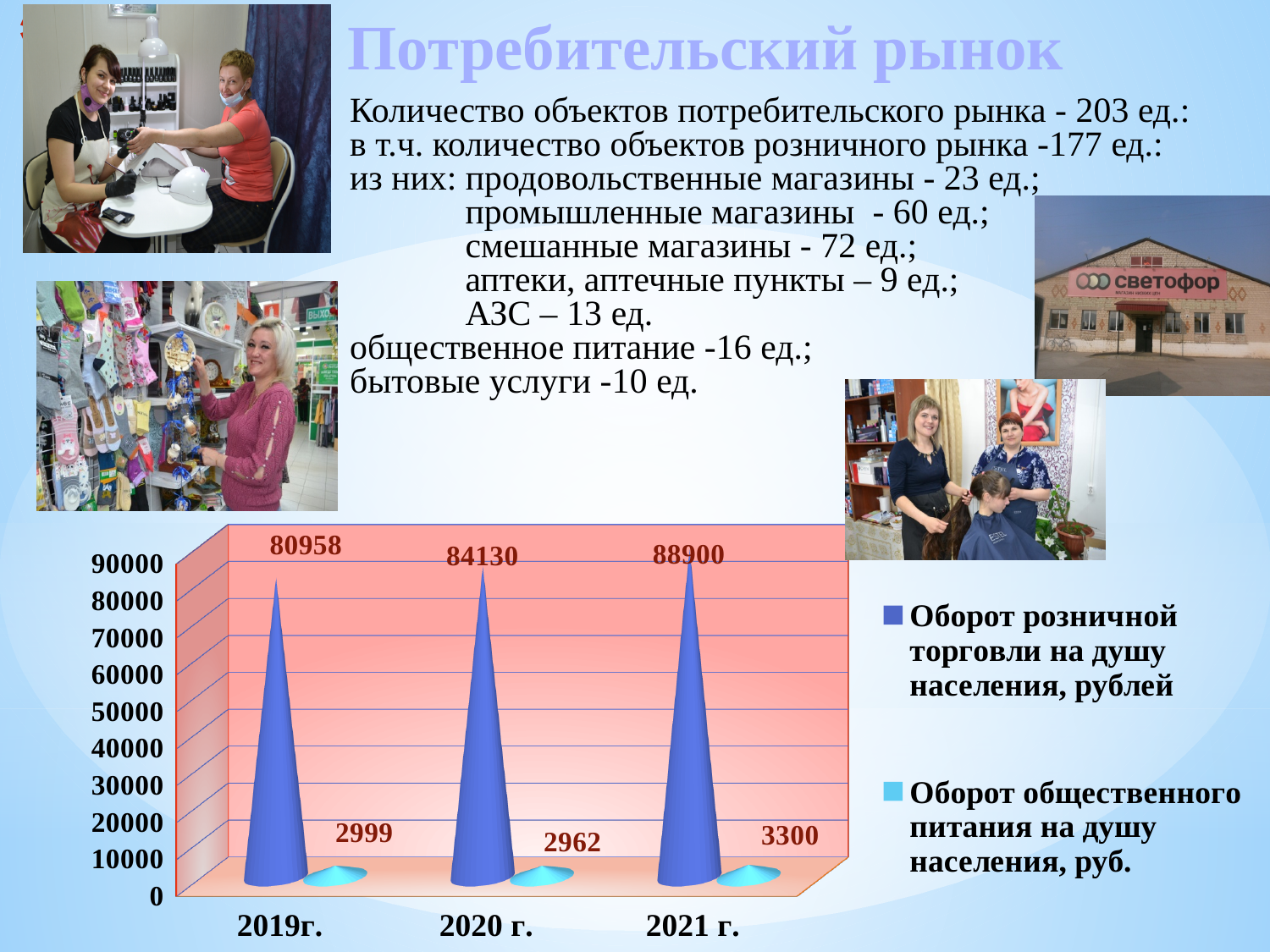
Is the value of 'Оборот розничной торговли на душу населения, рублей' for 2020 г. greater or less than 80000? greater Which is larger: 'Оборот общественного питания на душу населения, руб.' in 2019г. or in 2021 г.? 2021 г. How many years are shown on the x axis of the chart? 3 What is the value of 'Оборот розничной торговли на душу населения, рублей' for 2019г.? 80958 What kind of chart is shown on the slide? bar chart What is the value of 'Оборот розничной торговли на душу населения, рублей' for 2021 г.? 88900 In which year is 'Оборот розничной торговли на душу населения, рублей' highest? 2021 г. In which year is 'Оборот общественного питания на душу населения, руб.' lowest? 2020 г. What is the difference between 'Оборот розничной торговли на душу населения, рублей' in 2021 г. and in 2019г.? 7942 Does 'Оборот розничной торговли на душу населения, рублей' rise or fall from 2019г. to 2021 г.? rise How many series does the chart legend list? 2 What is the value of 'Оборот общественного питания на душу населения, руб.' for 2020 г.? 2962